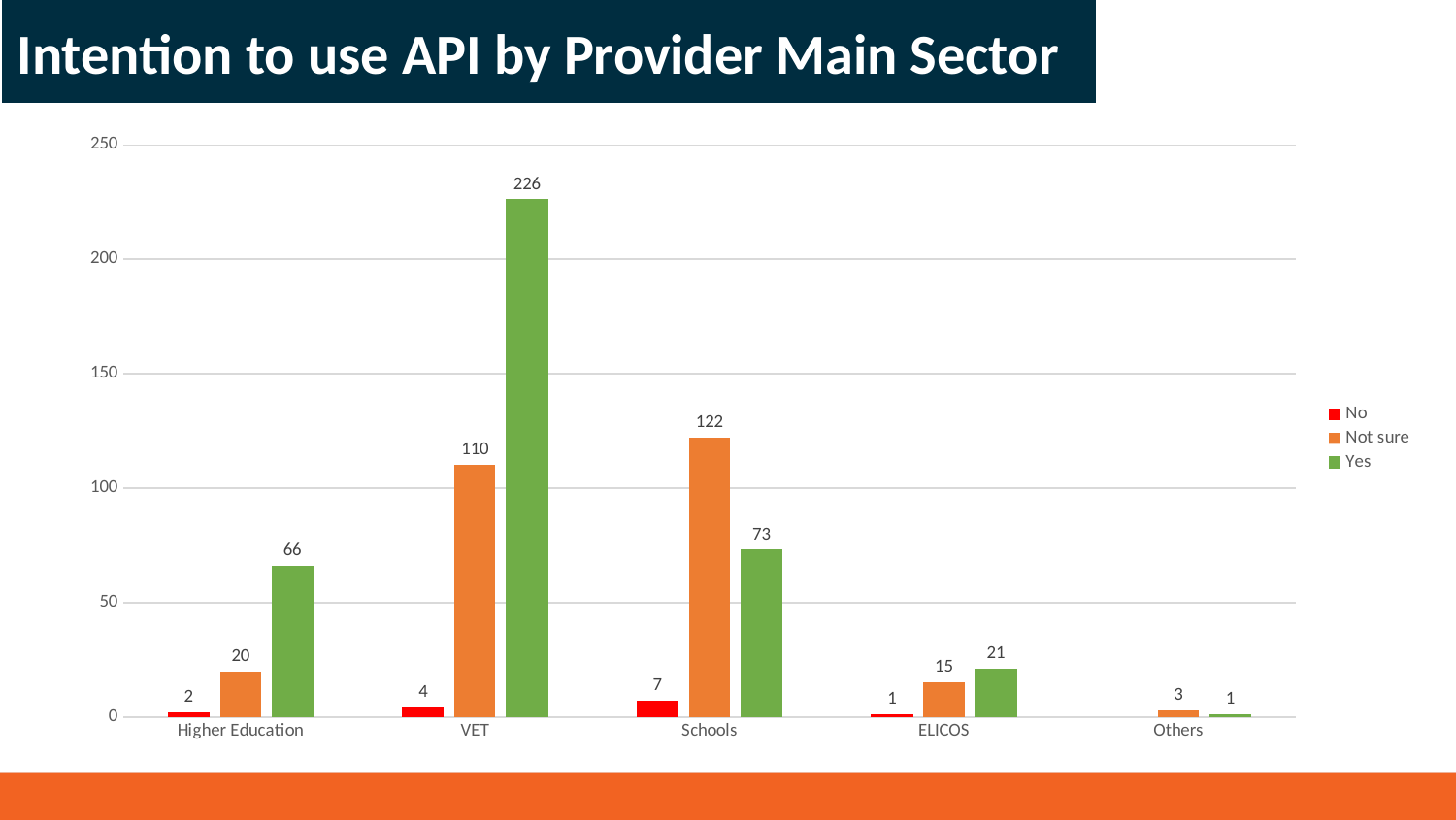
What is the value for "Not sure" in the Schools category? 122 What type of chart is shown on the slide? Bar chart What is the value for "Yes" in the ELICOS category? 21 Is the "Not sure" value for VET greater or less than 100? greater Which category has the highest "Yes" value? VET Which category has the lowest "Not sure" value? Others What is the difference between the "Yes" values for VET and Schools? 153 What is the value for "No" in the Higher Education category? 2 In the Schools category, which is larger: "Not sure" or "Yes"? Not sure How many provider sector categories are shown on the x axis? 5 What is the value for "Yes" in the VET category? 226 How many series does the legend list? 3